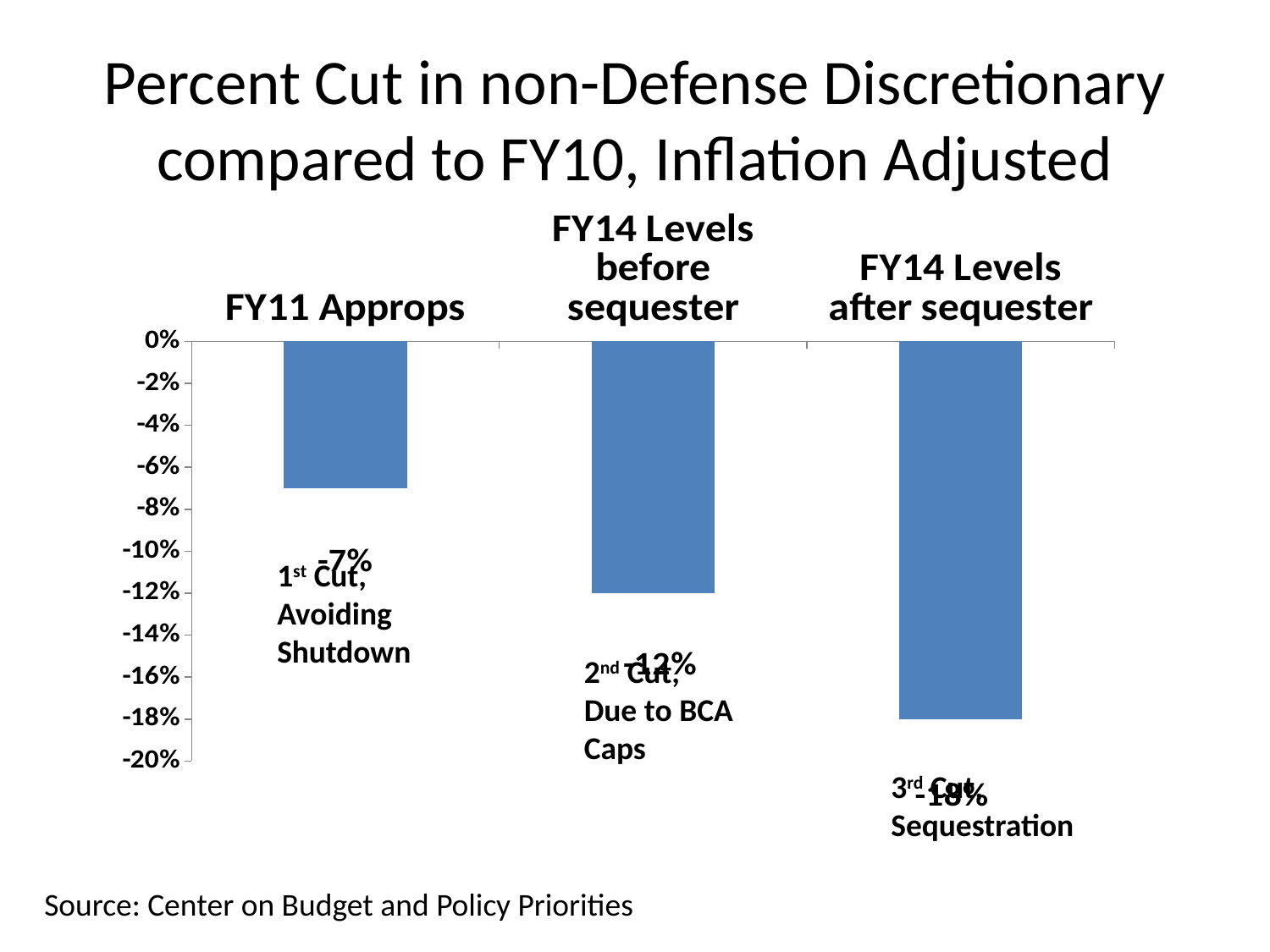
Which category shows the smallest percent cut? FY11 Approps What kind of chart is shown on the slide? Bar chart What is the value for FY11 Approps? -7% Which category shows the largest percent cut? FY14 Levels after sequester What is the difference between the values for FY11 Approps and FY14 Levels before sequester? 5 percentage points Do the values fall or rise moving from left to right across the categories? Fall What is the value for FY14 Levels before sequester? -12% What is the title of the chart? Percent Cut in non-Defense Discretionary compared to FY10, Inflation Adjusted Which is a deeper cut, FY11 Approps or FY14 Levels before sequester? FY14 Levels before sequester What is the value for FY14 Levels after sequester? -18% What is the difference between the values for FY14 Levels after sequester and FY14 Levels before sequester? 6 percentage points How many categories are shown in the chart? 3